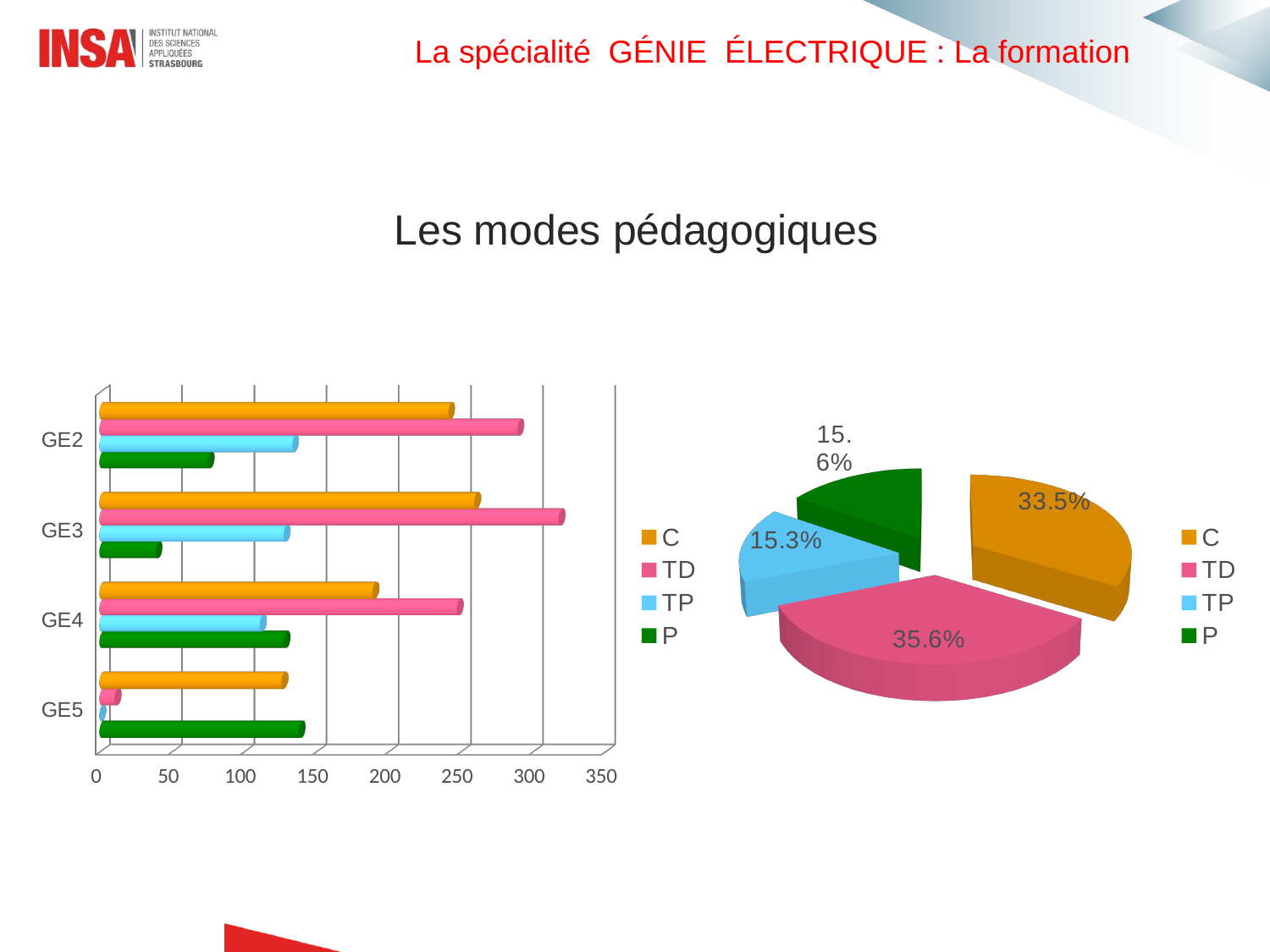
In the bar chart on the left, how many categories are shown on the vertical axis? 4 In the bar chart on the left, is the TD value for GE3 greater or less than 300? greater In the bar chart on the left, which category has the highest TD value? GE3 What kind of chart is the chart on the left of the slide? bar chart In the bar chart on the left, is the P value for GE2 greater or less than 100? less In the pie chart on the right, what share does TD have? 35.6% What kind of chart is the chart on the right of the slide? pie chart In the pie chart on the right, which slice is the smallest? TP In the bar chart on the left, how many series does the legend list? 4 In the bar chart on the left, which is larger: the C value for GE2 or the C value for GE4? GE2 In the bar chart on the left, is the TD value for GE5 greater or less than 50? less In the bar chart on the left, which category has the lowest TD value? GE5